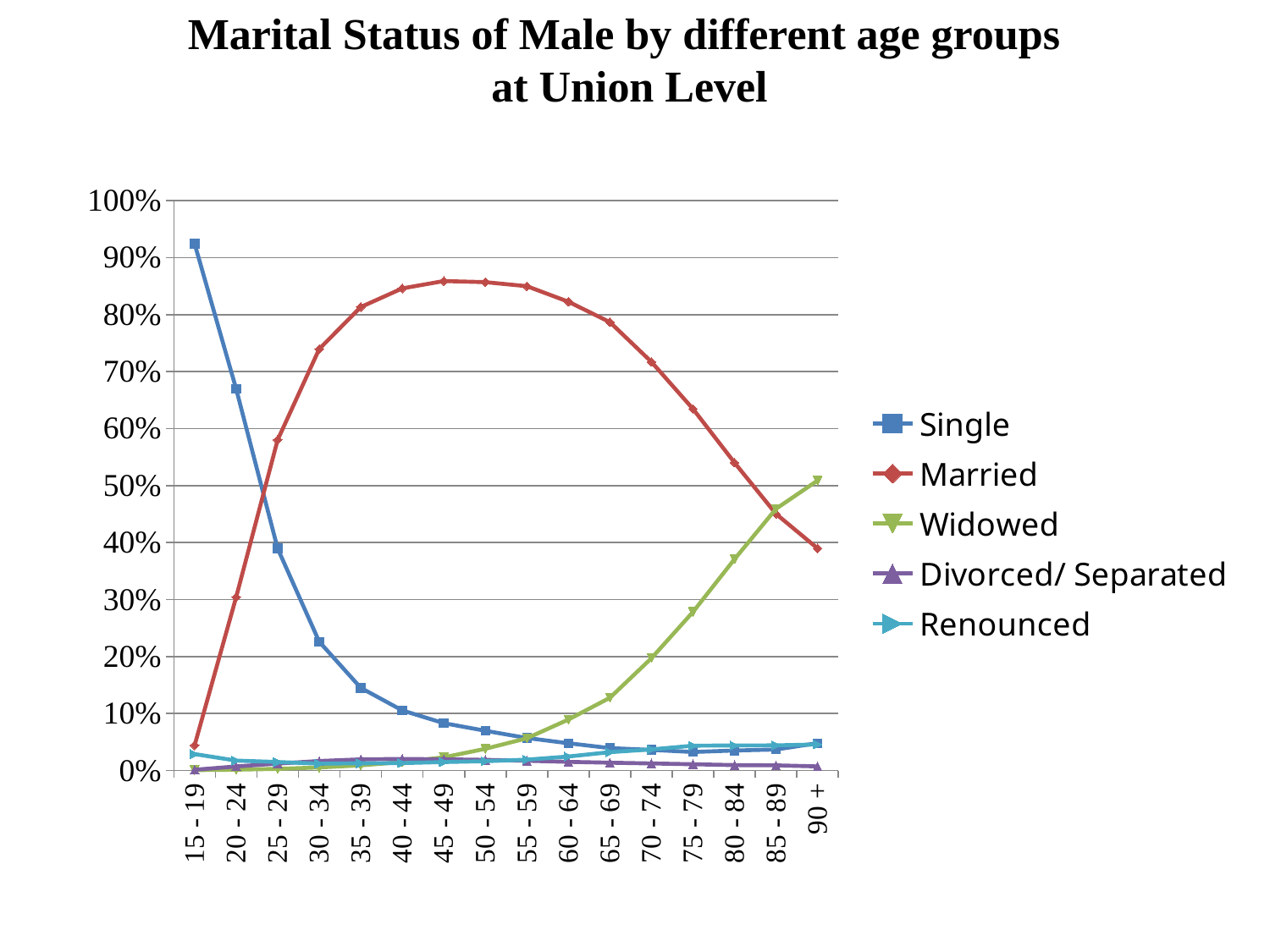
Is the value for Widowed in the 90 + age group greater or less than 40%? greater In the 25 - 29 age group, which is larger, Single or Married? Married What kind of chart is shown on the slide? line chart Is the value for Married in the 15 - 19 age group greater or less than 10%? less How many age groups are plotted along the x axis? 16 Is the value for Single in the 15 - 19 age group greater or less than 80%? greater Which age group has the lowest value for Married? 15 - 19 How many series does the legend list? 5 Which age group has the highest value for Single? 15 - 19 In the 90 + age group, which series has the higher value, Married or Widowed? Widowed Does the Widowed series rise or fall as age increases along the x axis? rises